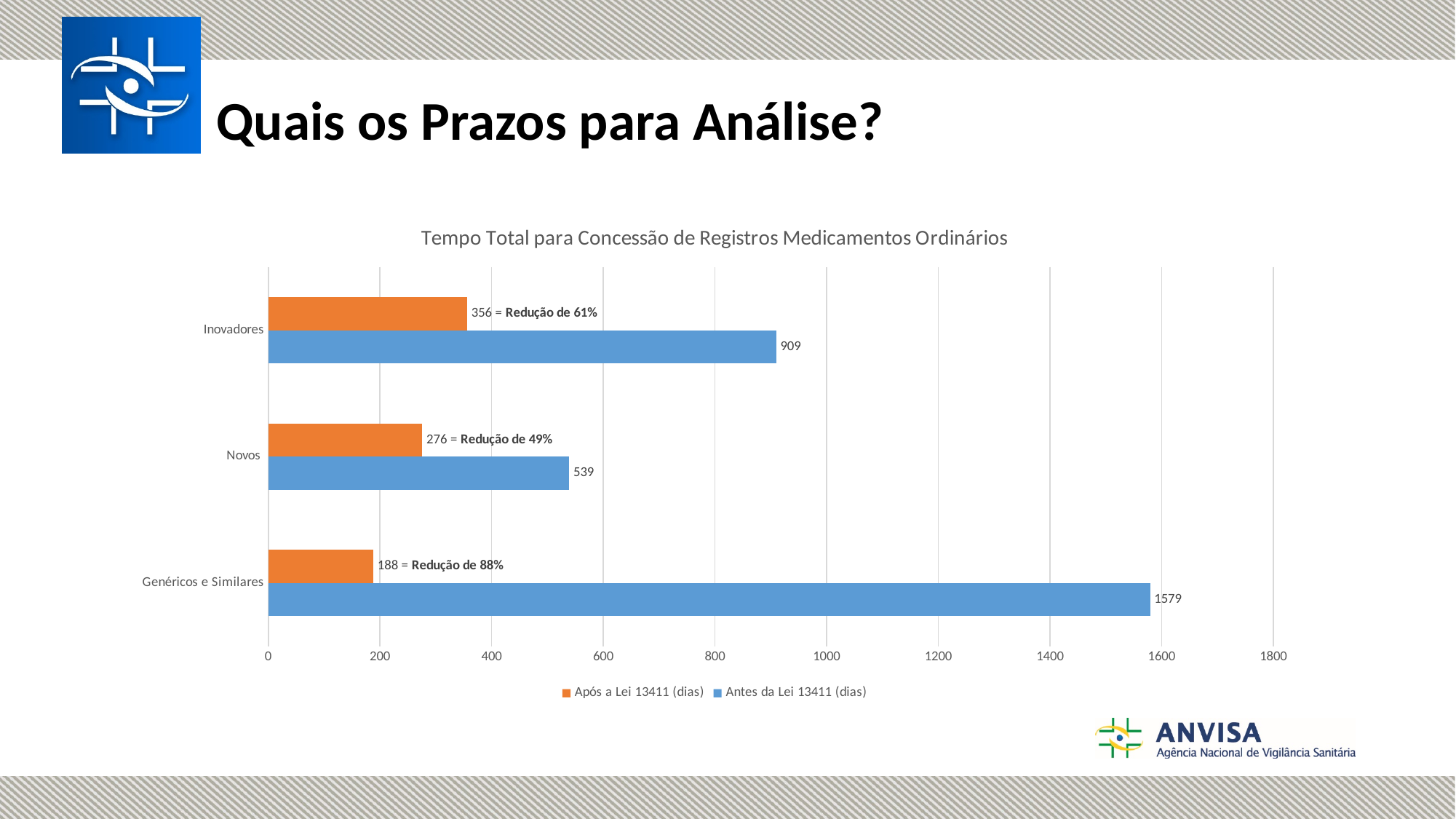
How many series does the legend list? 2 Which category has the highest value in the Antes da Lei 13411 (dias) series? Genéricos e Similares What is the title of the chart? Tempo Total para Concessão de Registros Medicamentos Ordinários What is the value for Novos in the Antes da Lei 13411 (dias) series? 539 Is the Antes da Lei 13411 (dias) value for Inovadores greater or less than 800? greater What is the difference between the Antes da Lei and Após a Lei values for Novos? 263 What kind of chart is shown on the slide? Bar chart How many categories are shown on the chart? 3 What is the value for Inovadores in the Após a Lei 13411 (dias) series? 356 Which category has the lowest value in the Após a Lei 13411 (dias) series? Genéricos e Similares Which is larger: the Antes da Lei value for Inovadores or the Antes da Lei value for Novos? Inovadores What is the value for Genéricos e Similares in the Antes da Lei 13411 (dias) series? 1579